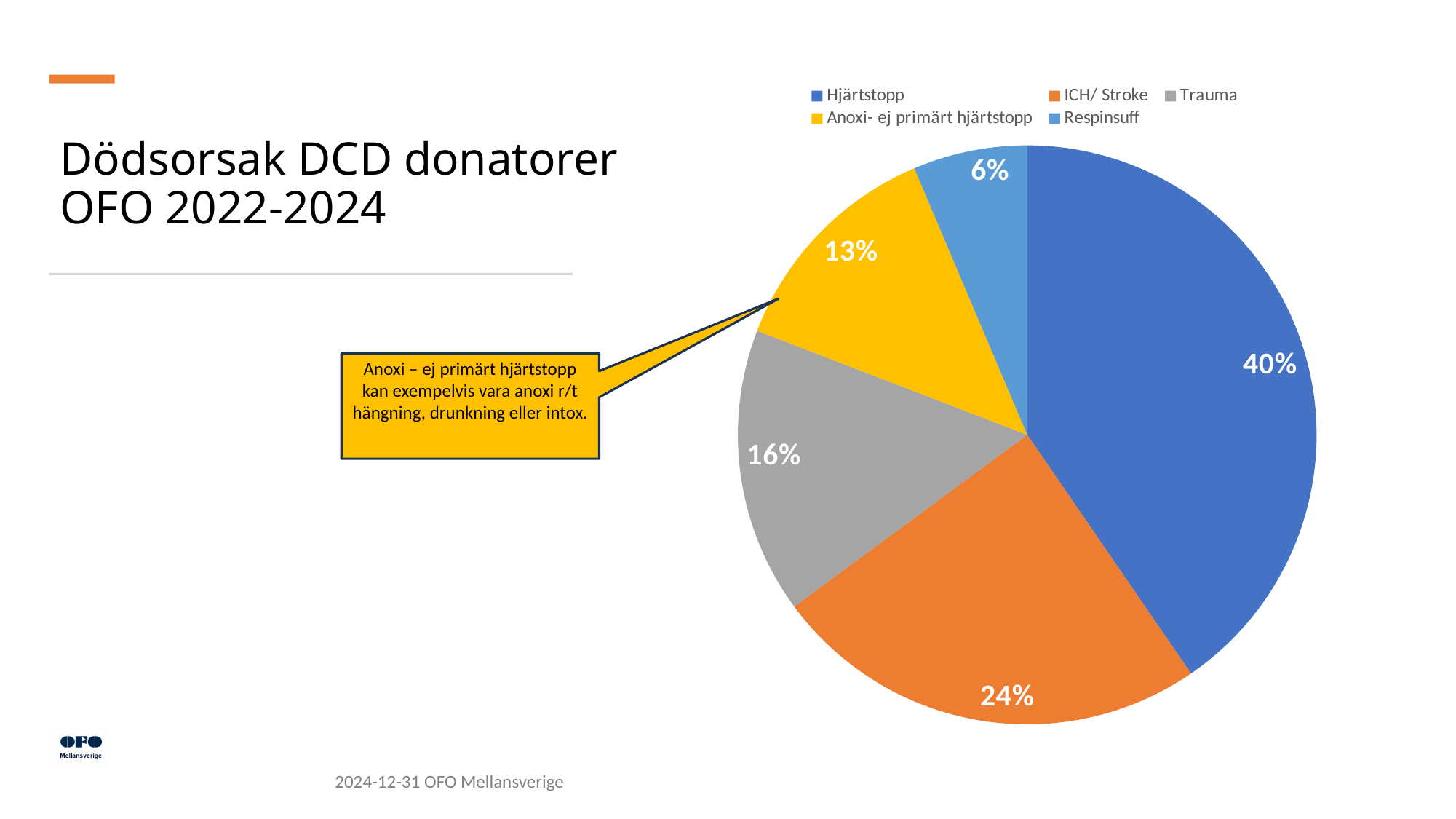
What share of the pie does Trauma account for? 16% What share of the pie does Anoxi- ej primärt hjärtstopp account for? 13% What kind of chart is shown on the slide? Pie chart What share of the pie does ICH/ Stroke account for? 24% What is the difference in percentage points between Hjärtstopp and ICH/ Stroke? 16 Which category is shown in grey in the pie chart? Trauma How many categories does the pie chart have? 5 Which is larger, the share for Trauma or the share for Anoxi- ej primärt hjärtstopp? Trauma Which category has the smallest share of the pie? Respinsuff Which category has the largest share of the pie? Hjärtstopp